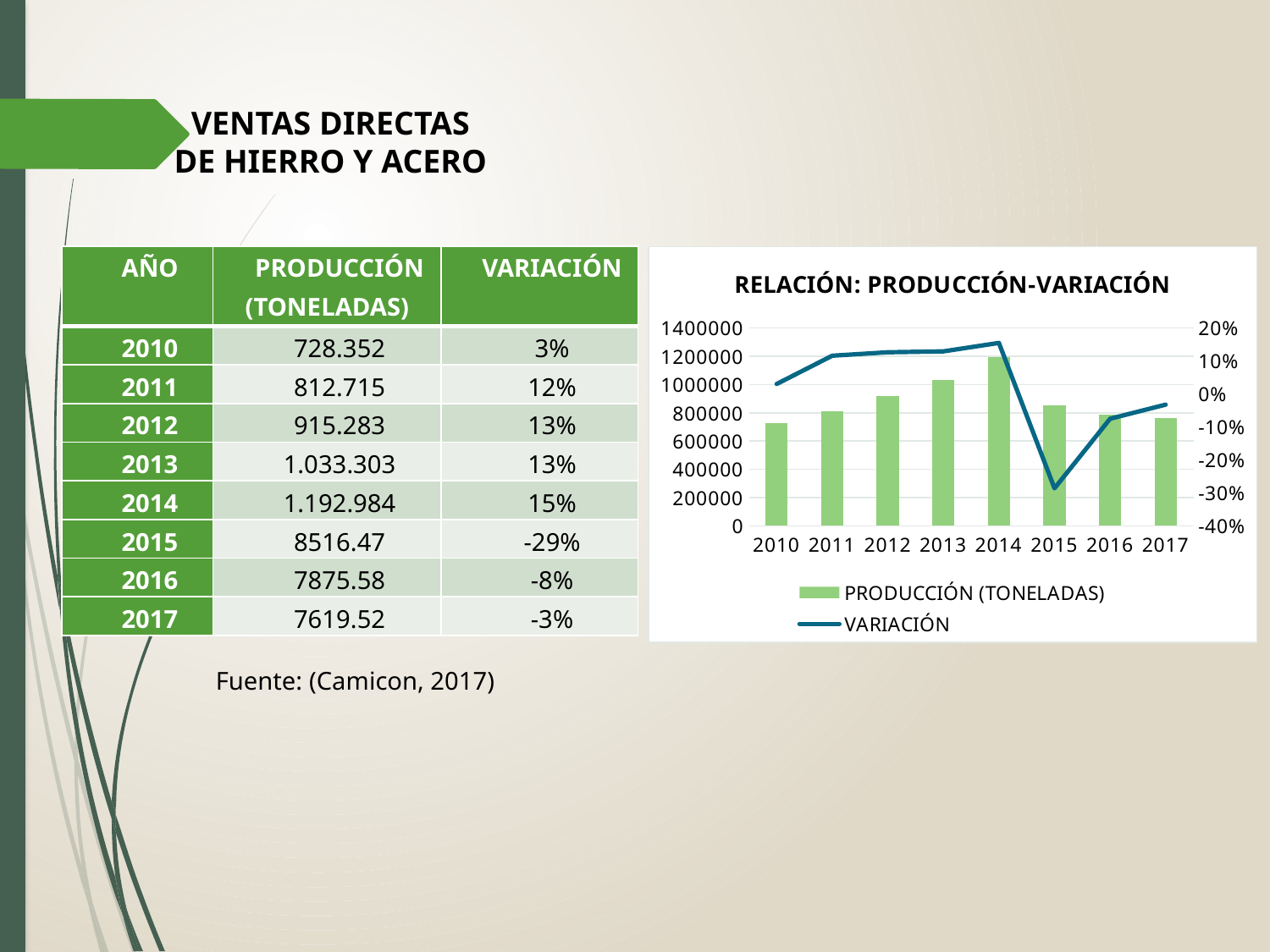
How many series does the chart legend list? 2 Do the PRODUCCIÓN (TONELADAS) bars rise or fall from 2010 to 2014? rise What is the VARIACIÓN value for 2014, as given in the table? 15% In which year does the VARIACIÓN line reach its lowest point? 2015 Which year has the tallest PRODUCCIÓN (TONELADAS) bar? 2014 How many years are shown on the x axis of the chart? 8 Which year has the taller PRODUCCIÓN (TONELADAS) bar, 2011 or 2012? 2012 What is the PRODUCCIÓN (TONELADAS) value for 2013, as given in the table? 1.033.303 What is the title of the chart? RELACIÓN: PRODUCCIÓN-VARIACIÓN Is the PRODUCCIÓN (TONELADAS) bar for 2010 greater or less than 800000? less What kind of chart is shown on the slide? A bar chart combined with a line Is the PRODUCCIÓN (TONELADAS) bar for 2014 greater or less than 1000000? greater